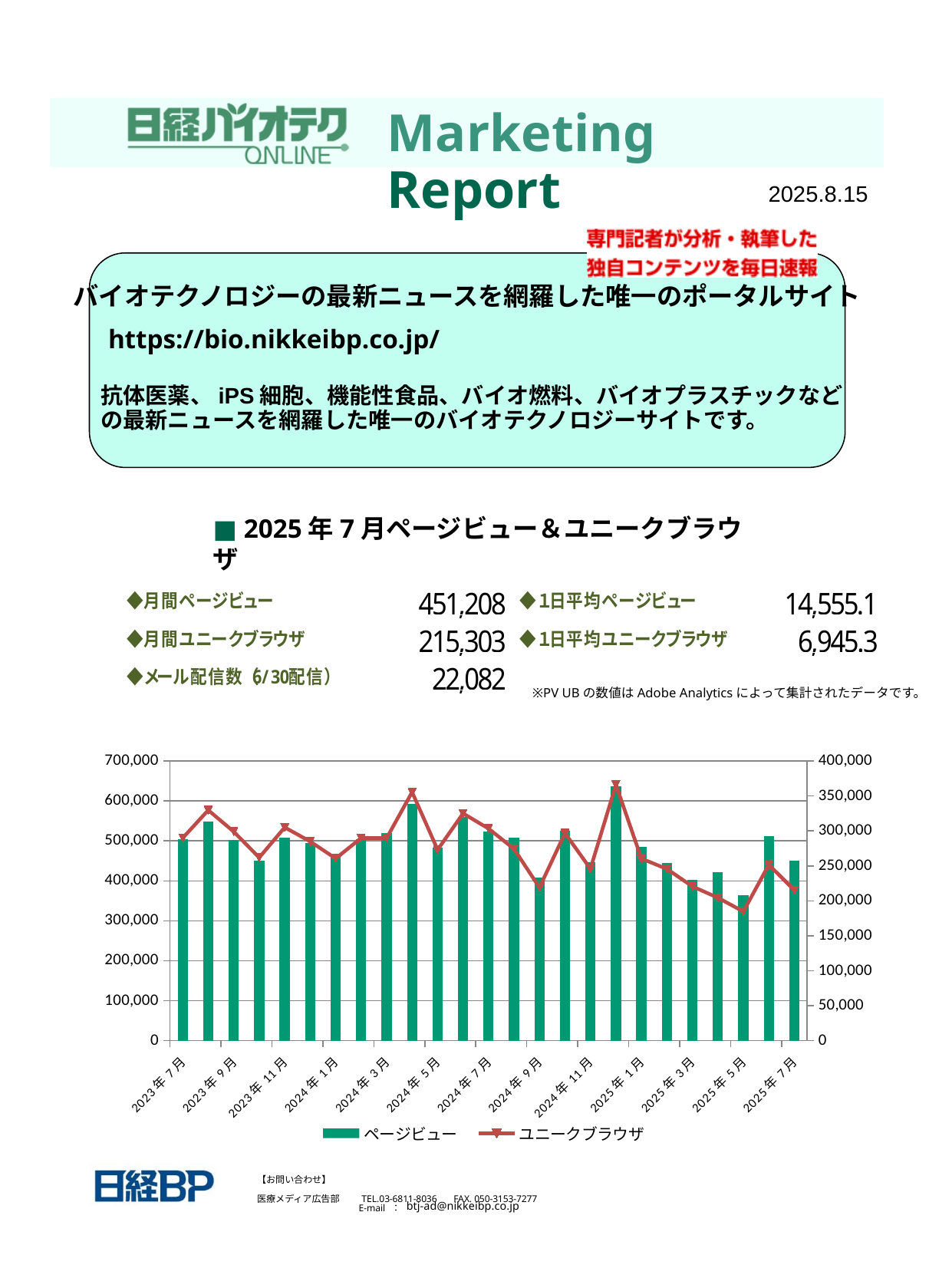
Is the ページビュー value for 2025年1月 greater or less than 600,000? less Which month has the highest ページビュー bar? 2024年12月 Do the ページビュー bars rise or fall from 2025年1月 to 2025年5月? fall Which month has the lowest ページビュー bar? 2025年5月 What kind of chart is shown on the slide? A bar chart combined with a line chart Is the ユニークブラウザ value for 2025年5月 greater or less than 200,000? less Which month has the larger ページビュー bar, 2023年7月 or 2023年8月? 2023年8月 What are the two series named in the chart legend? ページビュー and ユニークブラウザ How many monthly bars are plotted in the chart? 25 How many series does the chart legend list? 2 Is the ページビュー value for 2025年5月 greater or less than 400,000? less Which month has the lowest ユニークブラウザ value on the line? 2025年5月